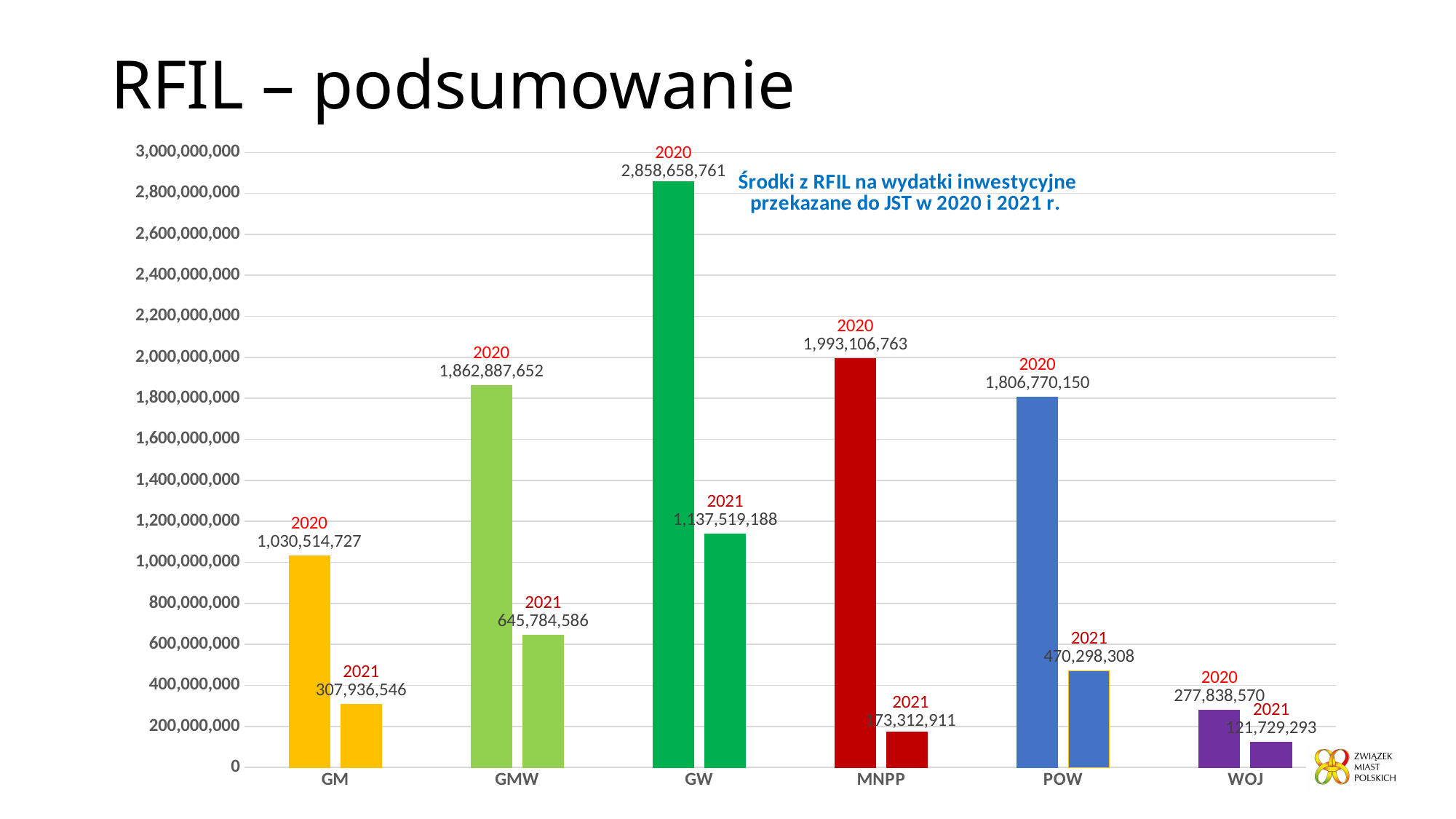
Which category has the lowest 2021 value? WOJ What is the 2020 value for POW? 1,806,770,150 What is the difference between the 2020 and 2021 values for GM? 722,578,181 What is the 2020 value for GW? 2,858,658,761 What type of chart is shown on the slide? bar chart Is the 2021 value for GMW greater or less than 800,000,000? less Which is larger: the 2020 value for MNPP or the 2020 value for GMW? MNPP What is the difference between the 2020 and 2021 values for GW? 1,721,139,573 What is the 2021 value for MNPP? 173,312,911 What is the 2021 value for WOJ? 121,729,293 How many categories are shown on the x axis? 6 Which category has the highest 2020 value? GW